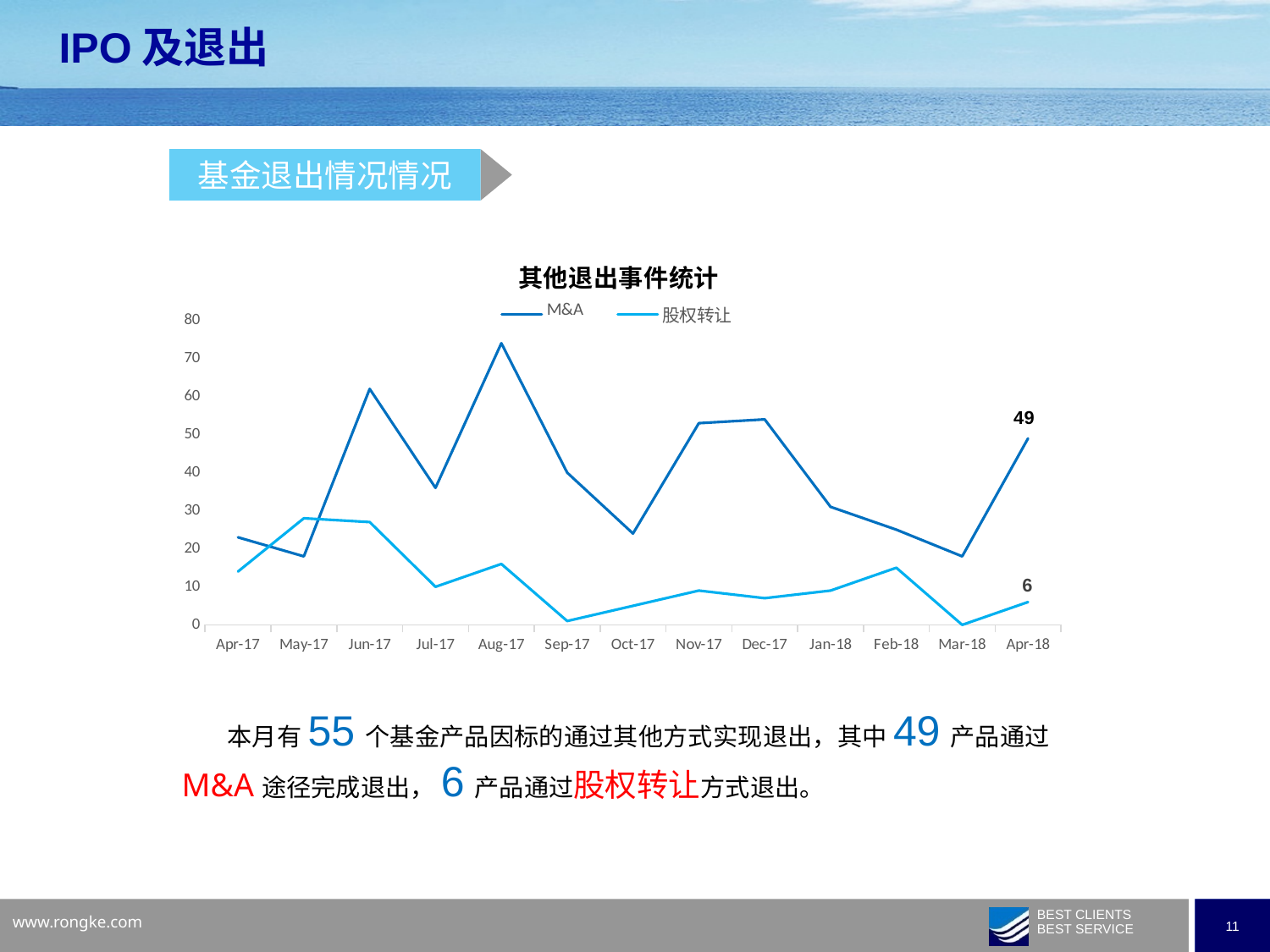
What is the title of the chart? 其他退出事件统计 Does the M&A series rise or fall from Mar-18 to Apr-18? rise Is the M&A value for Oct-17 greater or less than 30? less How many series does the legend of the chart list? 2 Which series has the larger value in Apr-18, M&A or 股权转让? M&A Is the M&A value for Aug-17 greater or less than 60? greater In which month does the M&A series reach its highest value? Aug-17 What is the difference between the M&A and 股权转让 values for Apr-18? 43 How many months are shown on the x axis of the chart? 13 What is the M&A value for Apr-18? 49 What kind of chart is shown on the slide? line chart What is the 股权转让 value for Apr-18? 6